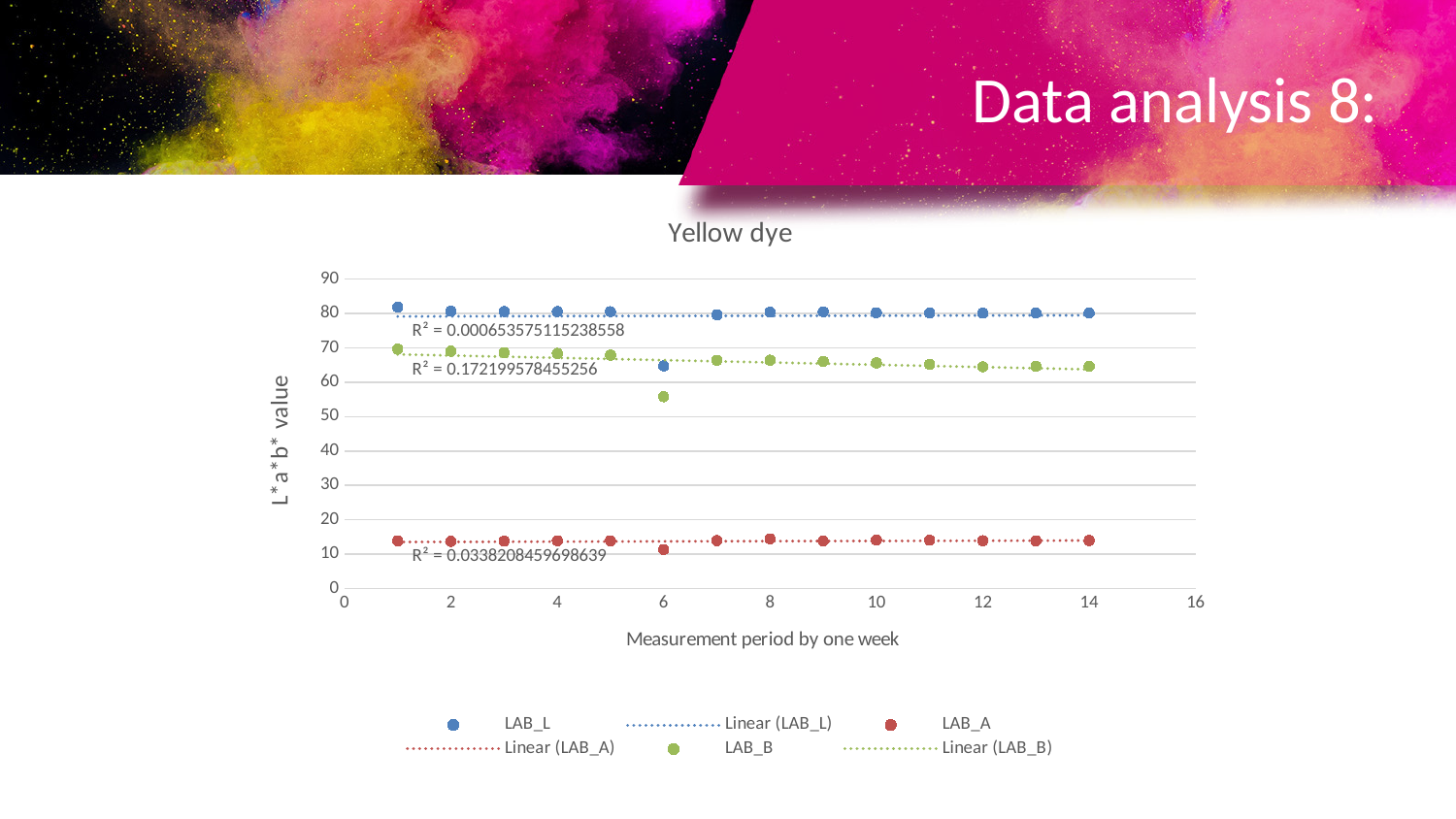
Is the LAB_L value at week 1 greater or less than 70? greater How many entries does the chart legend list? 6 Which series has the highest values across the measurement period? LAB_L How many data points are plotted for the LAB_L series? 14 What is the title of the chart? Yellow dye What is the label of the x axis? Measurement period by one week Which series has the lowest values across the measurement period? LAB_A Is the LAB_A value at week 10 greater or less than 20? less What kind of chart is shown on the slide? scatter chart What R² value is shown for the Linear (LAB_B) trendline? 0.172199578455256 At week 8, which is larger, the LAB_L value or the LAB_A value? LAB_L Is the LAB_B value at week 6 greater or less than 60? less